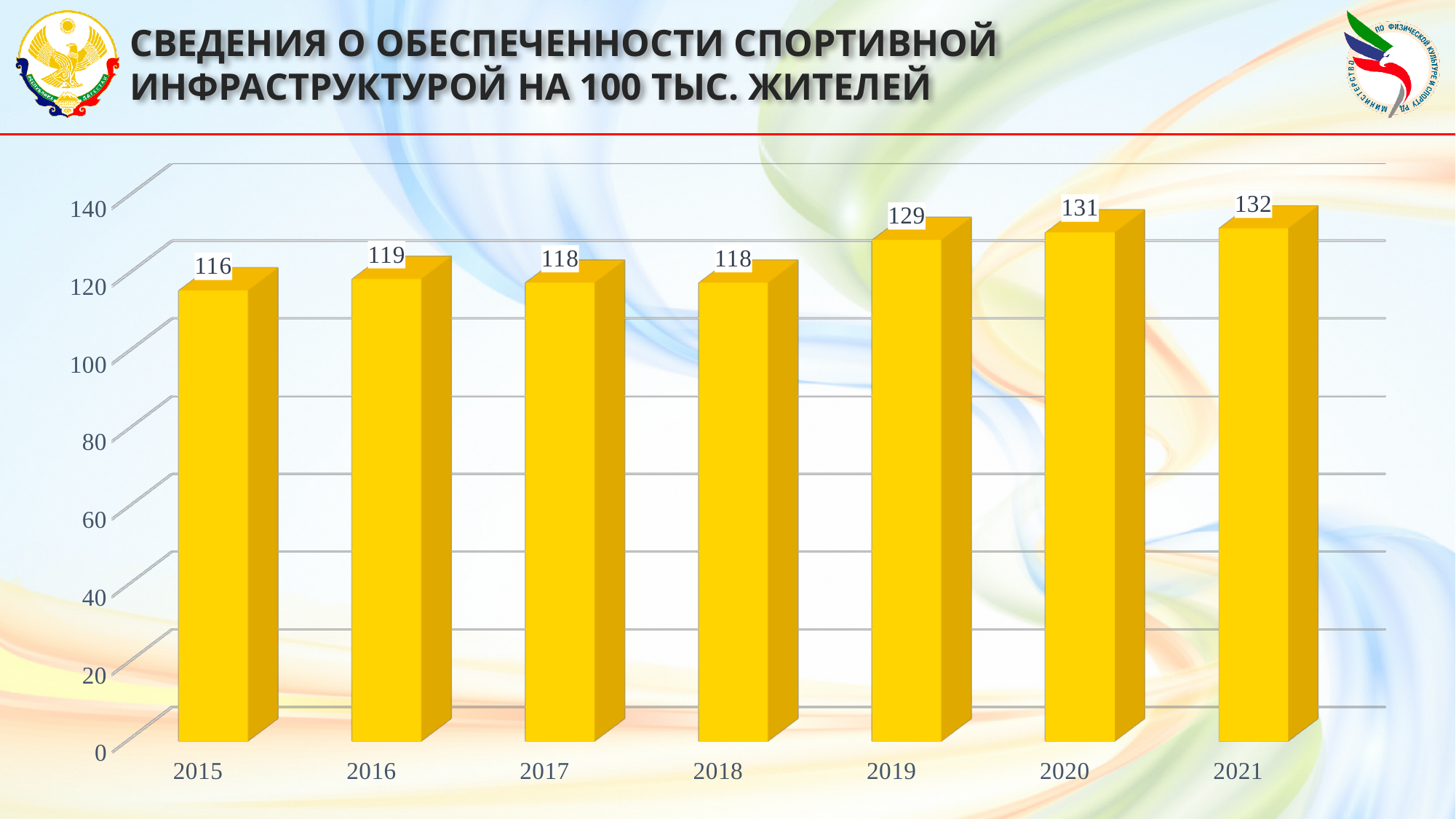
Which is larger, the value for 2016 or the value for 2018? 2016 What is the value for 2015? 116 What is the value for 2019? 129 Do the values generally rise or fall from 2015 to 2021? rise Is the value for 2020 greater or less than 120? greater What kind of chart is shown on the slide? bar chart What is the value for 2021? 132 Which year has the lowest value? 2015 What is the difference between the values for 2020 and 2019? 2 Which year has the highest value? 2021 How many years are shown on the x axis? 7 What is the difference between the values for 2021 and 2015? 16